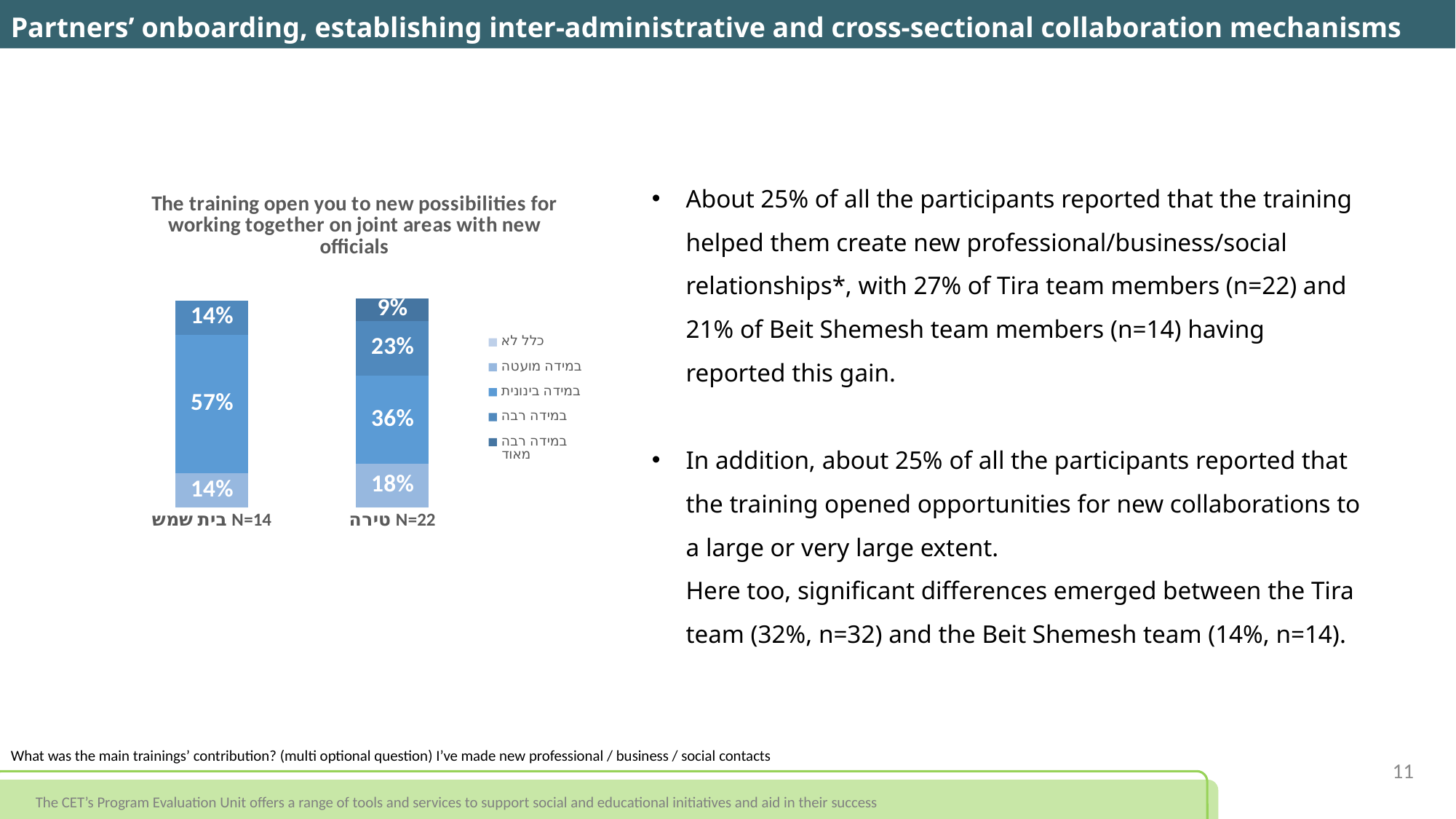
Which bar has the larger bottom segment, בית שמש (14%) or טירה (18%)? טירה What is the value of the largest segment in the בית שמש bar? 57% What is the value of the topmost segment in the טירה bar? 9% What is the sample size (N) shown for the טירה bar? N=22 What is the value of the middle (largest) segment in the טירה bar? 36% How many bars (groups) does the chart show? 2 What is the title of the chart? The training open you to new possibilities for working together on joint areas with new officials How many labelled segments does the טירה bar contain? 4 What is the difference between the largest segment of the בית שמש bar (57%) and the largest segment of the טירה bar (36%)? 21 percentage points How many series does the chart legend list? 5 What kind of chart is shown on the slide? Stacked bar chart What is the value of the bottom segment in the טירה bar? 18%